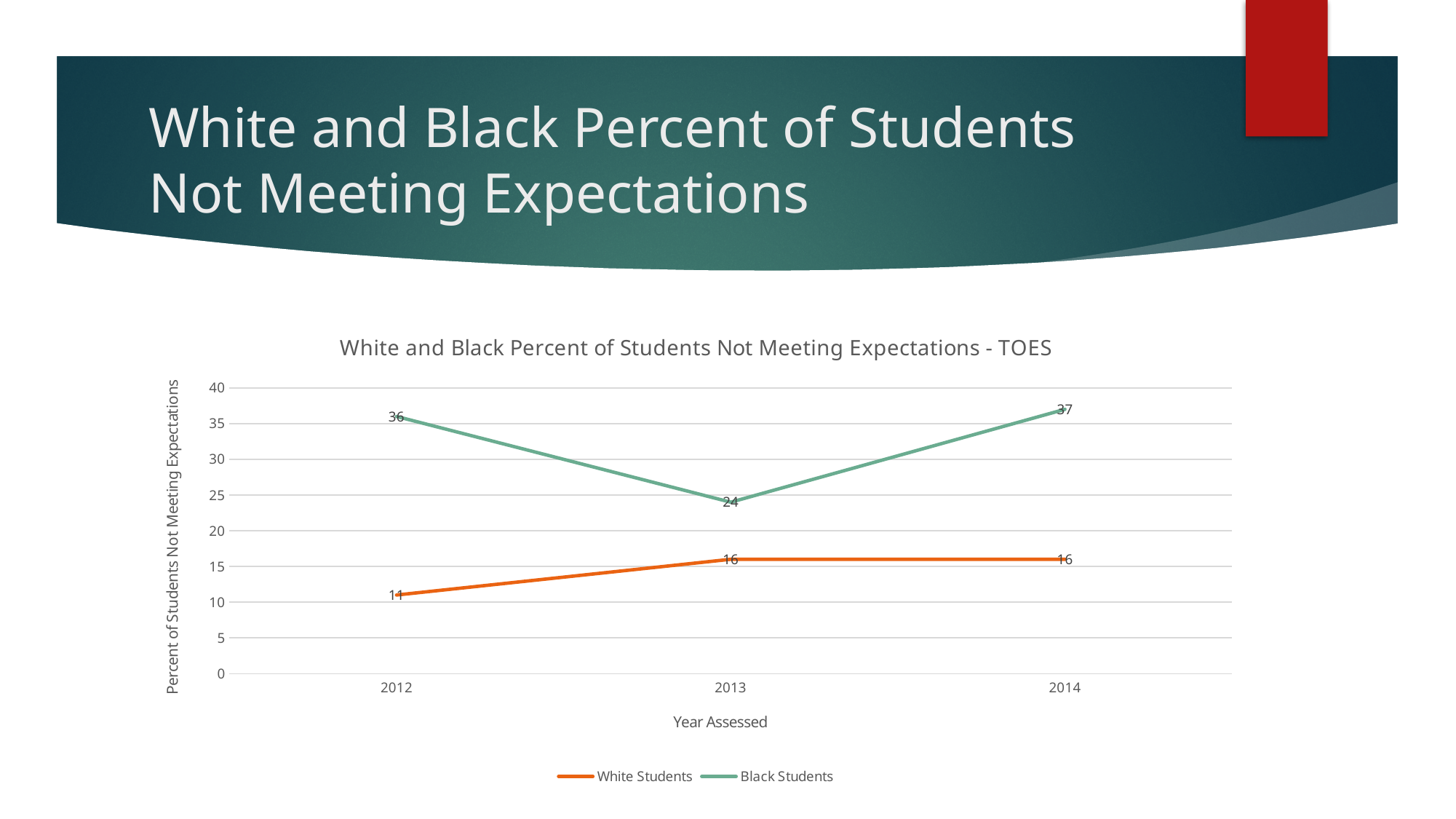
How many years are shown on the x axis? 3 What is the value for Black Students in 2014? 37 In which year is the value for White Students lowest? 2012 What is the value for Black Students in 2012? 36 How many series does the legend list? 2 What is the difference between the Black Students and White Students values in 2014? 21 Which series has the larger value in 2013, White Students or Black Students? Black Students What is the label of the y axis? Percent of Students Not Meeting Expectations What kind of chart is shown on the slide? Line chart In which year is the value for Black Students lowest? 2013 What is the difference between the Black Students values in 2012 and 2013? 12 What is the value for White Students in 2013? 16